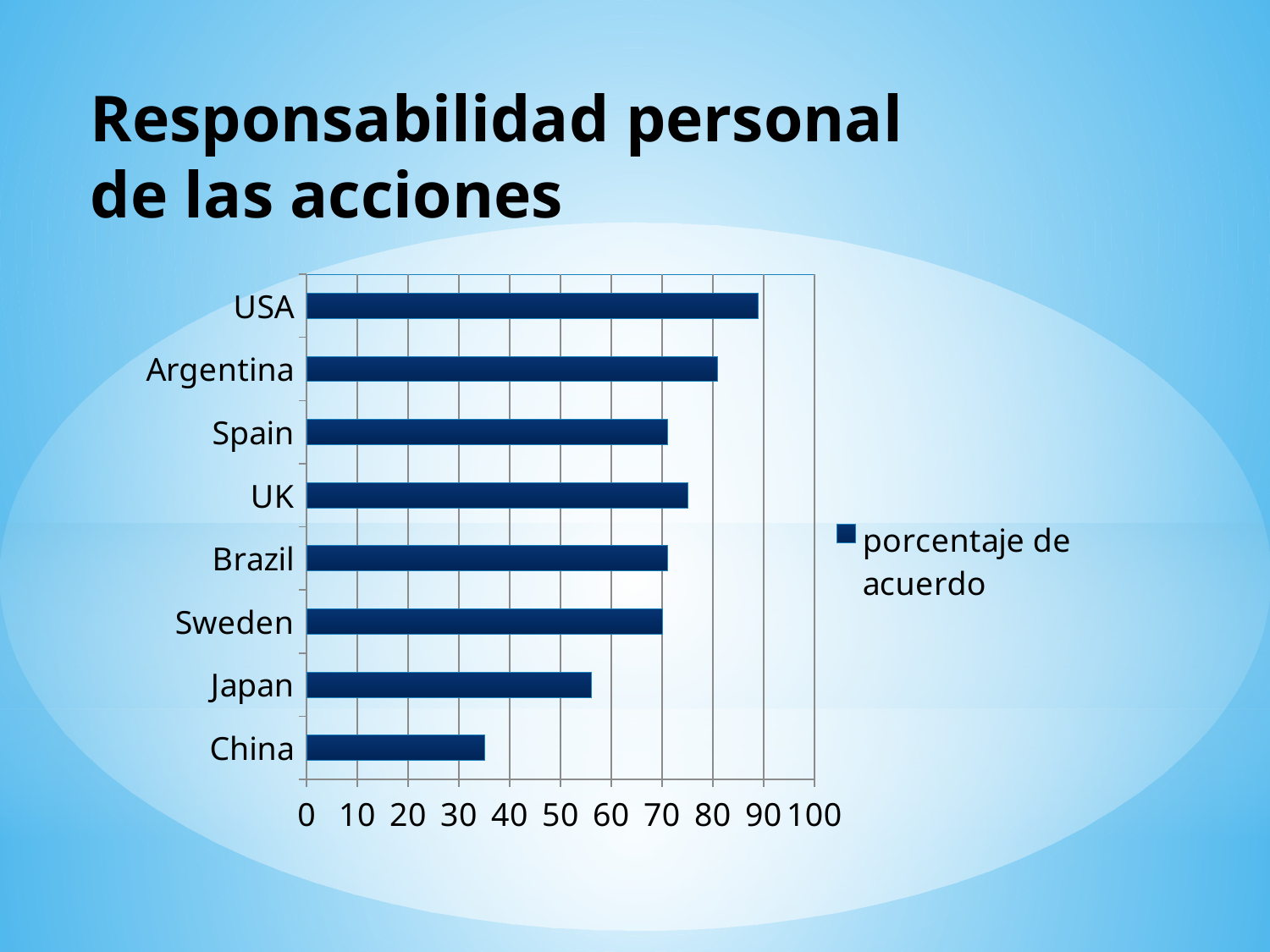
How many countries are shown in the chart? 8 What kind of chart is shown on the slide? bar chart How many series does the legend list? 1 Which has the larger value, Japan or China? Japan Is the value for China greater or less than 40? less Which country has the lowest value in the chart? China Is the value for Argentina greater or less than 70? greater Which has the larger value, USA or Argentina? USA Is the value for Japan greater or less than 50? greater Which country has the highest value in the chart? USA What is the name of the series shown in the legend? porcentaje de acuerdo